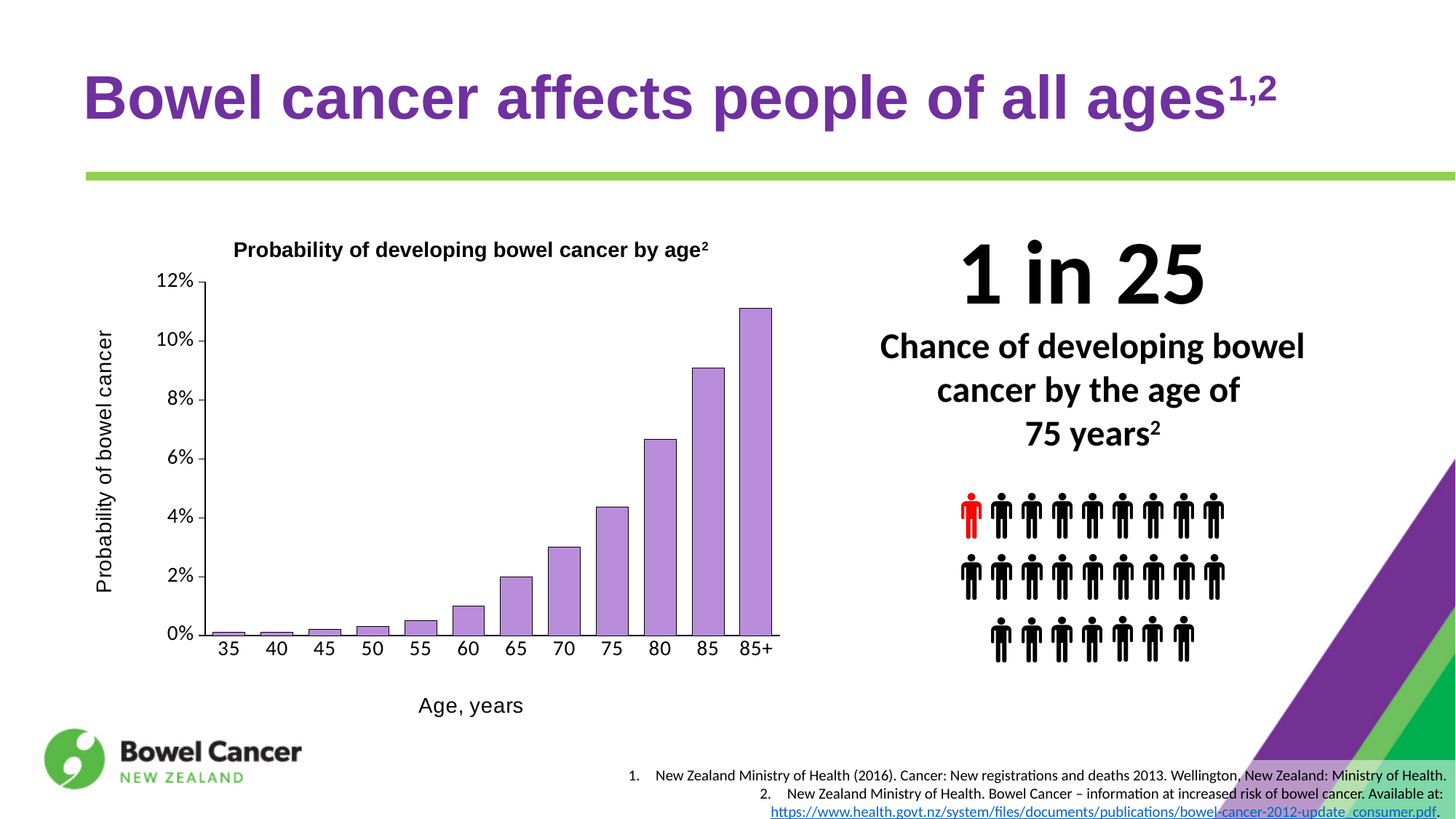
What kind of chart is shown on the slide? bar chart Is the value for age 75 greater or less than 4%? greater Is the value for age 85+ greater or less than 10%? greater Which is larger, the value for age 80 or the value for age 85? 85 How many age categories are shown on the x axis of the chart? 12 Which age category has the highest probability of developing bowel cancer? 85+ What is the title of the chart? Probability of developing bowel cancer by age Do the values rise or fall as age increases along the x axis? rise Is the value for age 85 greater or less than 8%? greater What is the label of the x axis of the chart? Age, years